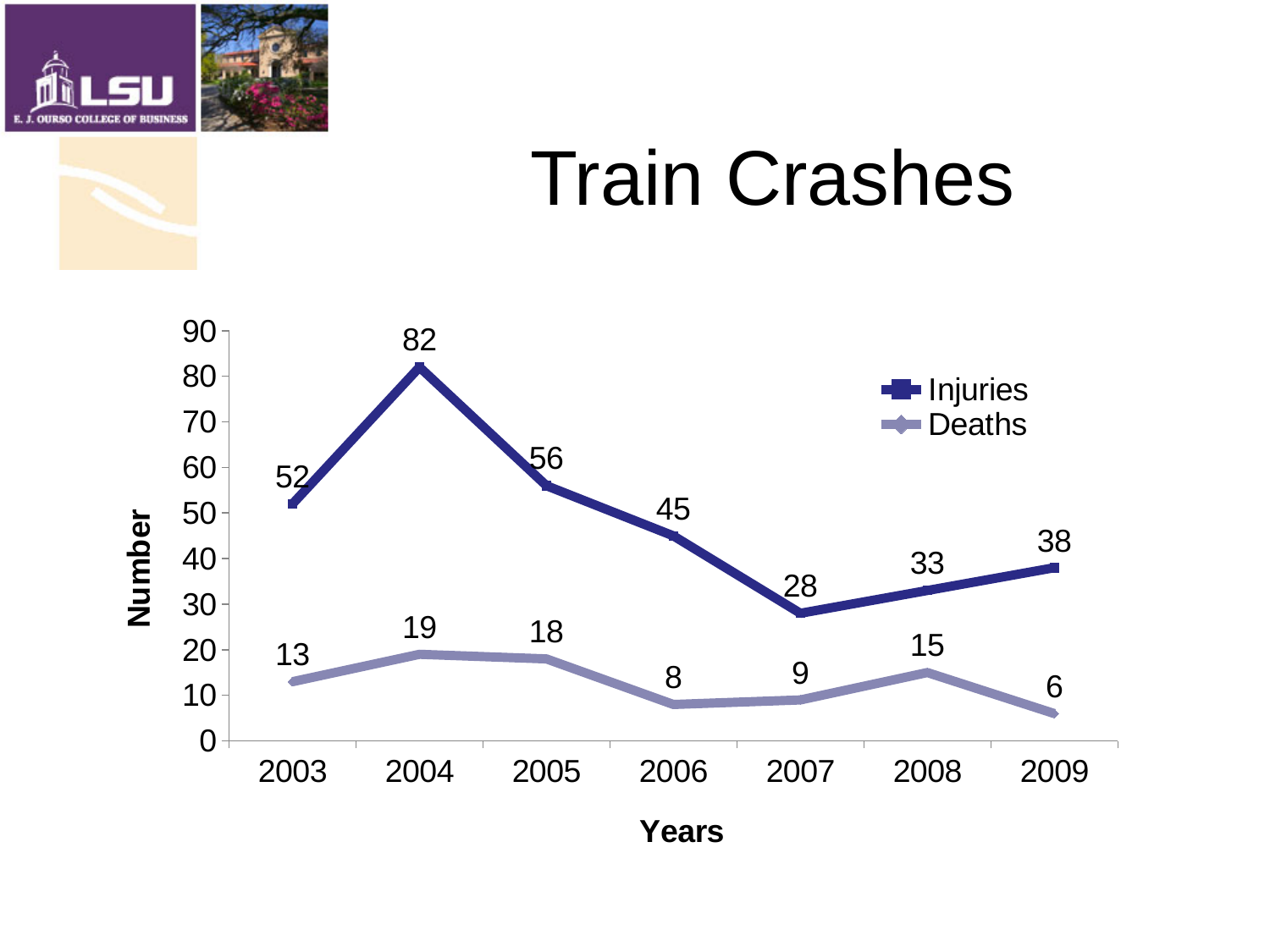
What is the difference between injuries and deaths in 2007? 19 Do injuries rise or fall from 2004 to 2007? fall How many series does the legend list? 2 What is the title of the chart? Train Crashes What is the number of deaths in 2006? 8 In which year were injuries highest? 2004 What is the number of injuries in 2004? 82 Which year had more injuries, 2005 or 2009? 2005 In which year were deaths lowest? 2009 Is the number of injuries in 2006 greater or less than 40? greater How many years are shown on the x axis? 7 What kind of chart is shown? line chart